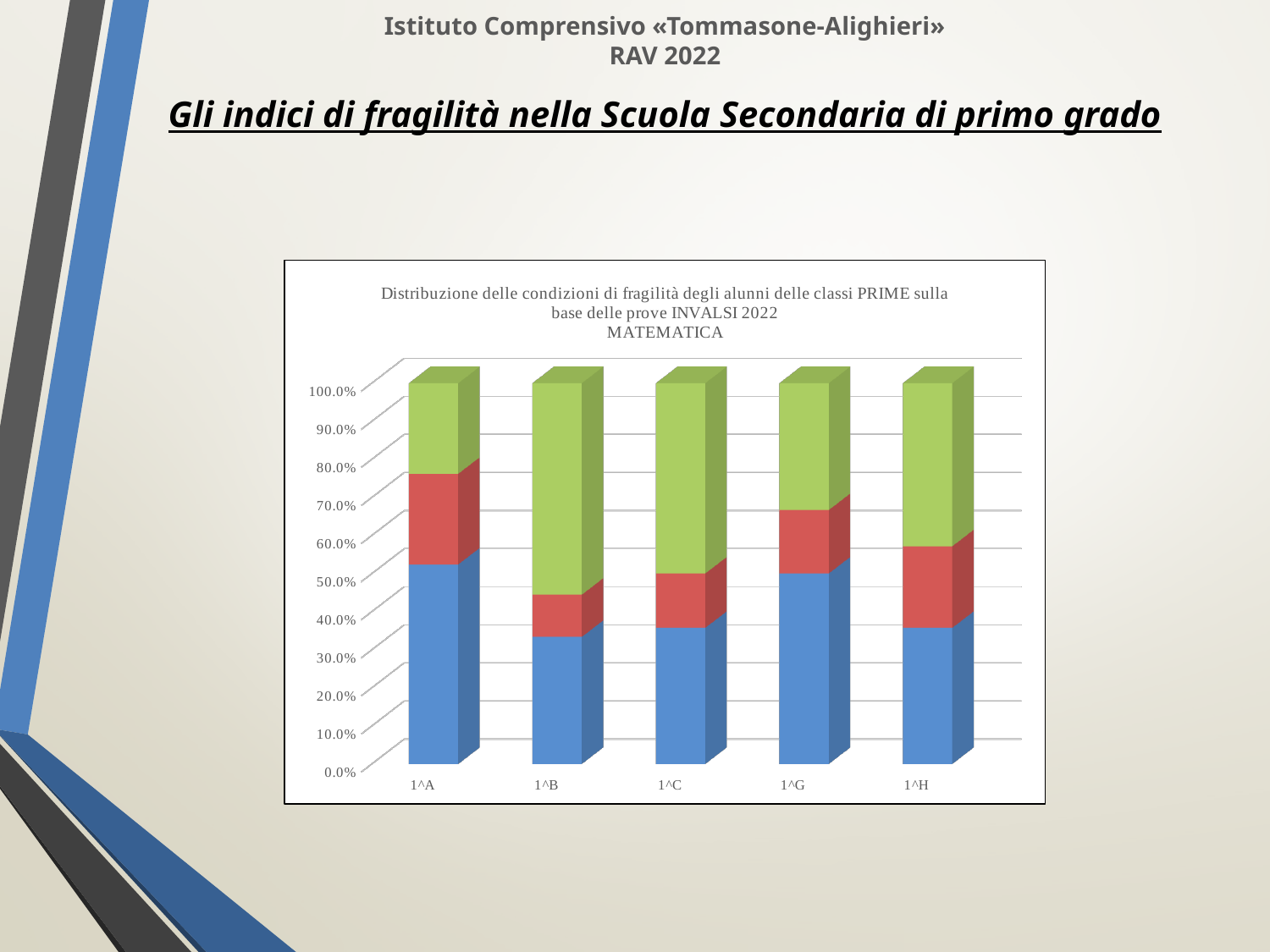
Is the blue (bottom) segment for 1^H greater or less than 50%? less What subject is named in the chart title? MATEMATICA Is the blue (bottom) segment for 1^C greater or less than 50%? less Which class has the larger blue (bottom) segment, 1^A or 1^B? 1^A Is the blue (bottom) segment for 1^A greater or less than 50%? greater How many classes (categories) are shown on the x axis of the chart? 5 Which class has the smallest green (top) segment? 1^A Which class has the largest green (top) segment? 1^B What kind of chart is shown on the slide? Stacked bar chart Which classes are listed along the x axis of the chart? 1^A, 1^B, 1^C, 1^G, 1^H